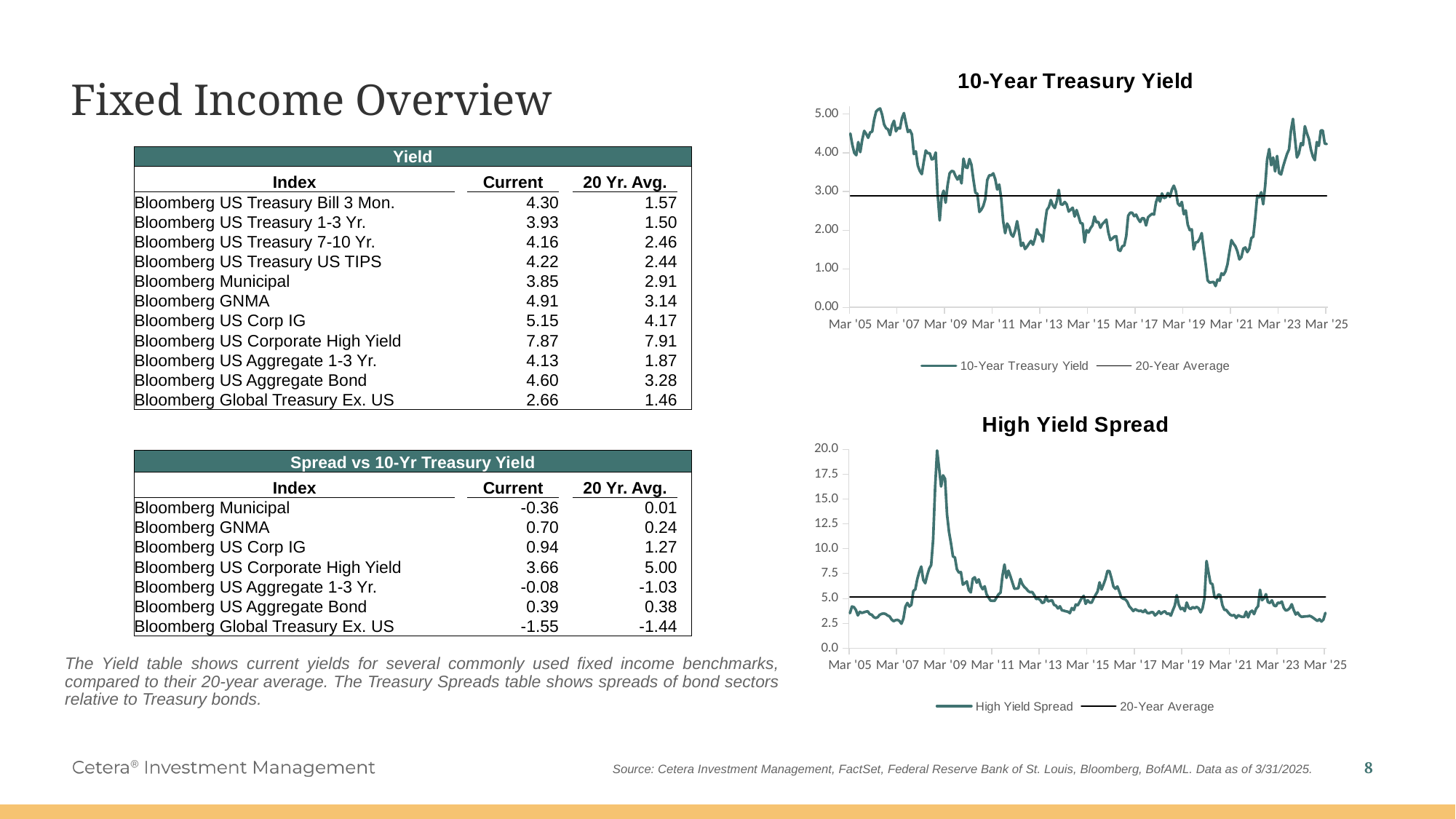
How many series does the legend of the High Yield Spread chart list? 2 In the 10-Year Treasury Yield chart, is the value at Mar '25 greater or less than 4.00? greater In the 10-Year Treasury Yield chart, is the value around Mar '20 greater or less than 1.00? less What is the title of the lower chart on the right side of the slide? High Yield Spread In the High Yield Spread chart, is the peak value around 2009 greater or less than 15.0? greater What kind of chart is the 10-Year Treasury Yield chart? line chart In the 10-Year Treasury Yield chart, does the yield rise or fall between Mar '07 and Mar '09? fall In the 10-Year Treasury Yield chart, does the yield rise or fall between Mar '21 and Mar '23? rise What are the two legend entries of the 10-Year Treasury Yield chart? 10-Year Treasury Yield and 20-Year Average How many x-axis labels are shown on the High Yield Spread chart? 11